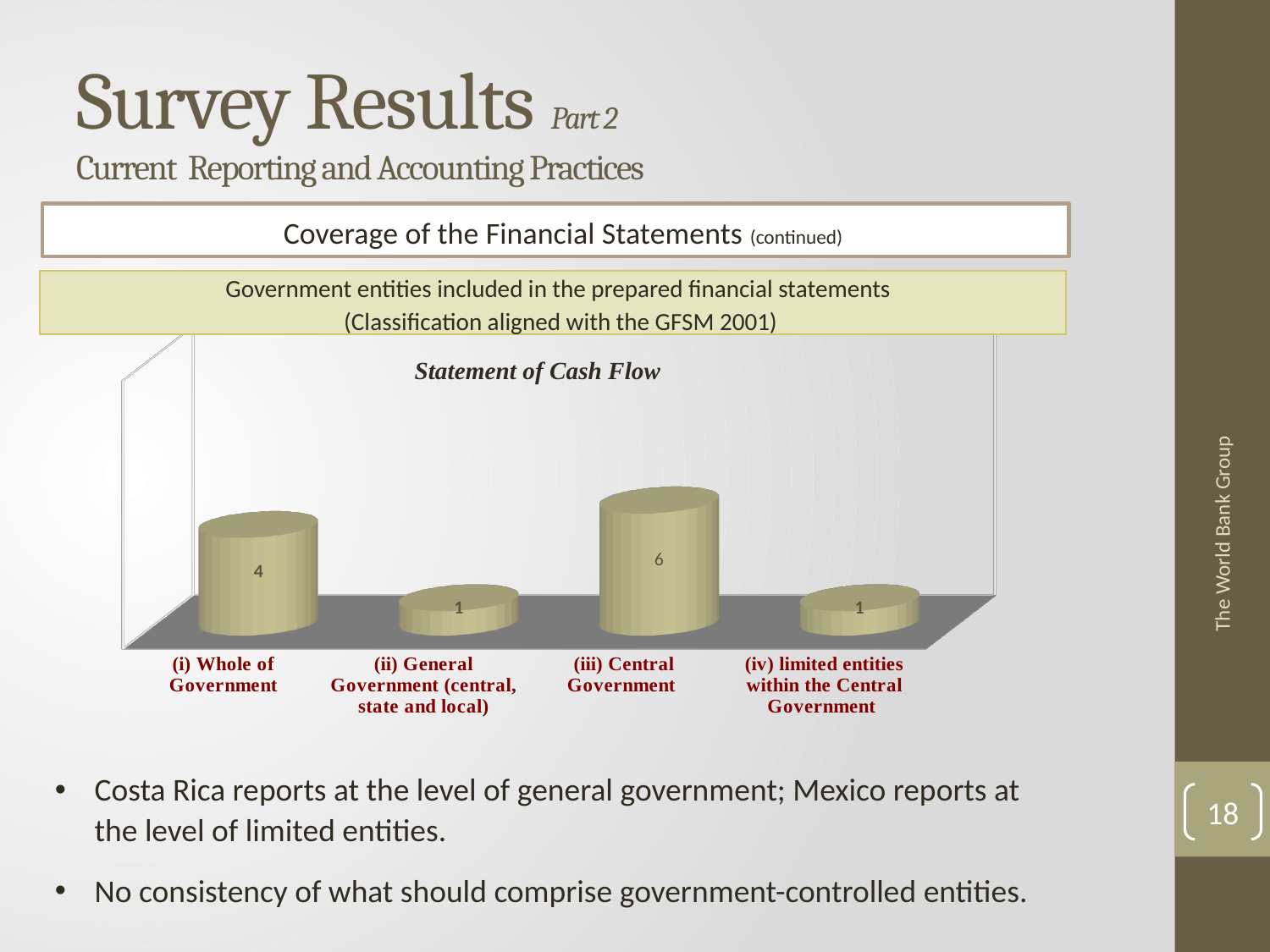
How many categories are shown in the chart? 4 What is the difference between the values for (iii) Central Government and (i) Whole of Government? 2 What is the difference between the values for (i) Whole of Government and (ii) General Government (central, state and local)? 3 Which is larger, the value for (i) Whole of Government or the value for (iv) limited entities within the Central Government? (i) Whole of Government What is the value for (i) Whole of Government? 4 What kind of chart is shown on the slide? bar chart Which category has the highest value? (iii) Central Government What is the title of the chart? Statement of Cash Flow What is the value for (iv) limited entities within the Central Government? 1 What is the value for (ii) General Government (central, state and local)? 1 What is the total of all four values in the chart? 12 What is the value for (iii) Central Government? 6